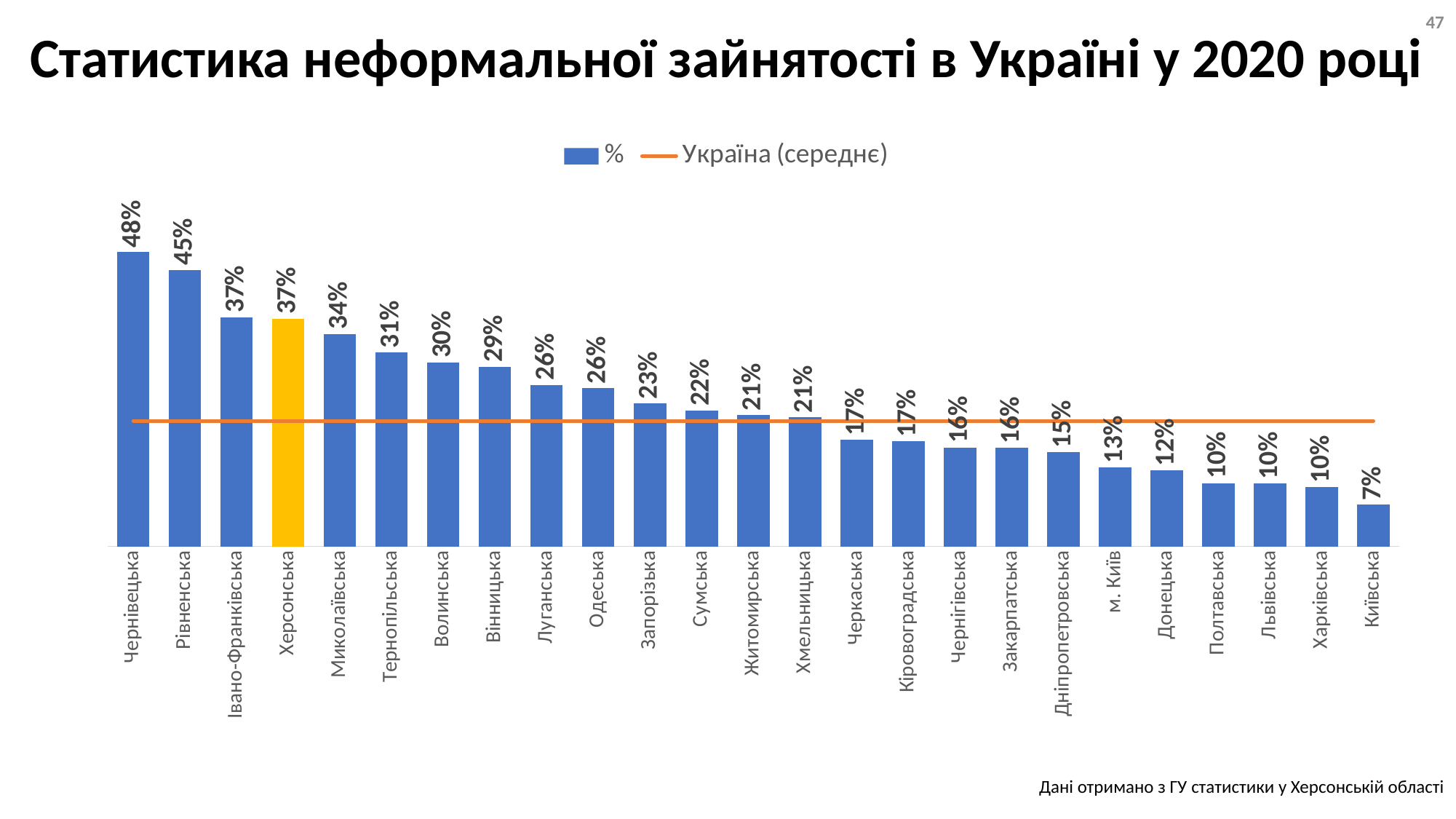
What is the value for м. Київ? 13% Which is larger, the value for Луганська or the value for Сумська? Луганська Which region has the highest value? Чернівецька What is the difference between the values for Чернівецька and Рівненська? 3% What is the difference between the values for Тернопільська and Київська? 24% How many series does the legend list? 2 What is the value for Херсонська? 37% What is the value for Миколаївська? 34% How many regions are shown on the x axis? 25 Which bar is highlighted in a different colour (yellow)? Херсонська What kind of chart is shown on the slide? Bar chart Which region has the lowest value? Київська